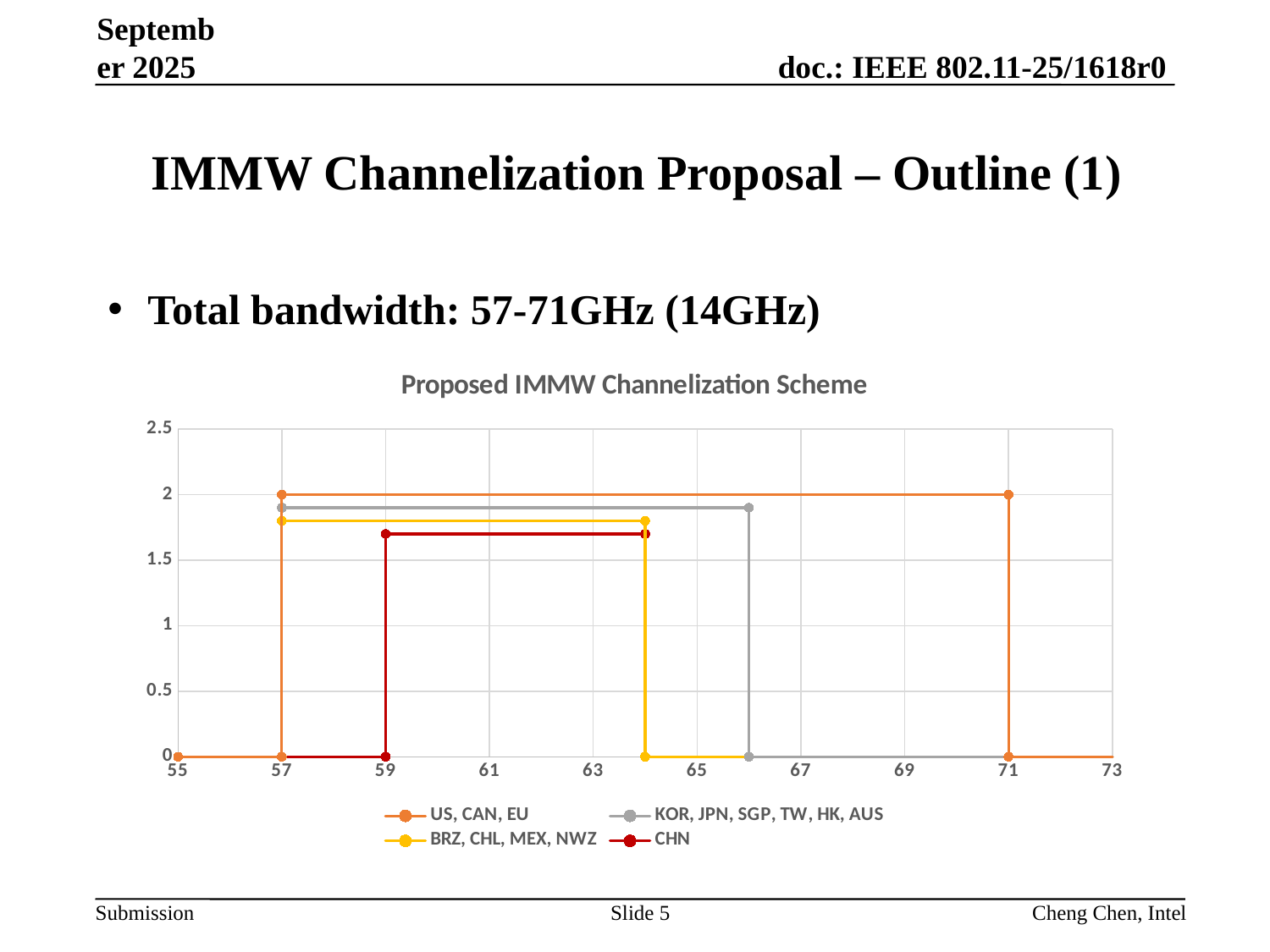
Is the plateau value of the CHN series greater or less than 1.5? greater Which series has the highest plateau value? US, CAN, EU What kind of chart is shown on the slide? line chart How many series does the legend of the chart list? 4 Which series spans a wider range on the x axis, US, CAN, EU or CHN? US, CAN, EU What is the plateau value of the US, CAN, EU series? 2 What is the title of the chart? Proposed IMMW Channelization Scheme At what x-axis value does the US, CAN, EU series rise from 0 to its plateau? 57 At what x-axis value does the US, CAN, EU series drop back to 0? 71 Which series has the lowest plateau value? CHN Is the x-axis value where the KOR, JPN, SGP, TW, HK, AUS series drops to 0 greater or less than 65? greater At what x-axis value does the CHN series rise from 0 to its plateau? 59